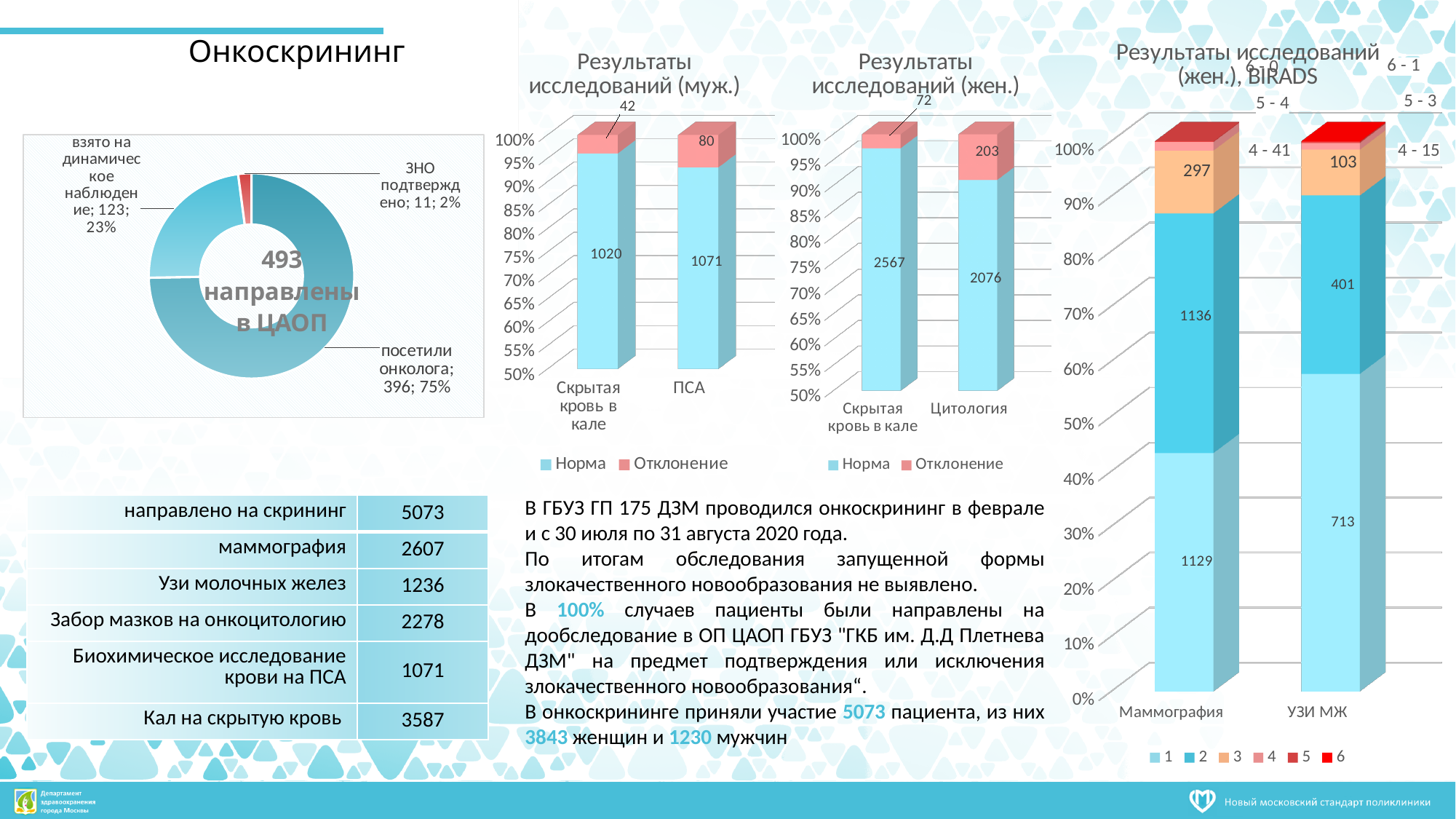
In the chart 'Результаты исследований (жен.), BIRADS', how many series does the legend list? 6 In the chart 'Результаты исследований (муж.)', what is the 'Норма' value for 'ПСА'? 1071 In the chart 'Результаты исследований (муж.)', how many series does the legend list? 2 In the donut chart '493 направлены в ЦАОП', which category is the smallest? ЗНО подтверждено In the donut chart '493 направлены в ЦАОП', what value is shown for 'посетили онколога'? 396; 75% In the chart 'Результаты исследований (жен.)', what is the 'Норма' value for 'Цитология'? 2076 In the chart 'Результаты исследований (жен.)', what is the difference between the 'Отклонение' values for 'Цитология' and 'Скрытая кровь в кале'? 131 In the chart 'Результаты исследований (жен.), BIRADS', what is the value of series '3' for 'УЗИ МЖ'? 103 In the chart 'Результаты исследований (муж.)', what is the 'Отклонение' value for 'Скрытая кровь в кале'? 42 In the chart 'Результаты исследований (жен.)', which category has the larger 'Норма' value, 'Скрытая кровь в кале' or 'Цитология'? Скрытая кровь в кале In the donut chart '493 направлены в ЦАОП', what share does 'взято на динамическое наблюдение' have? 23% In the chart 'Результаты исследований (жен.), BIRADS', what is the value of series '1' for 'Маммография'? 1129